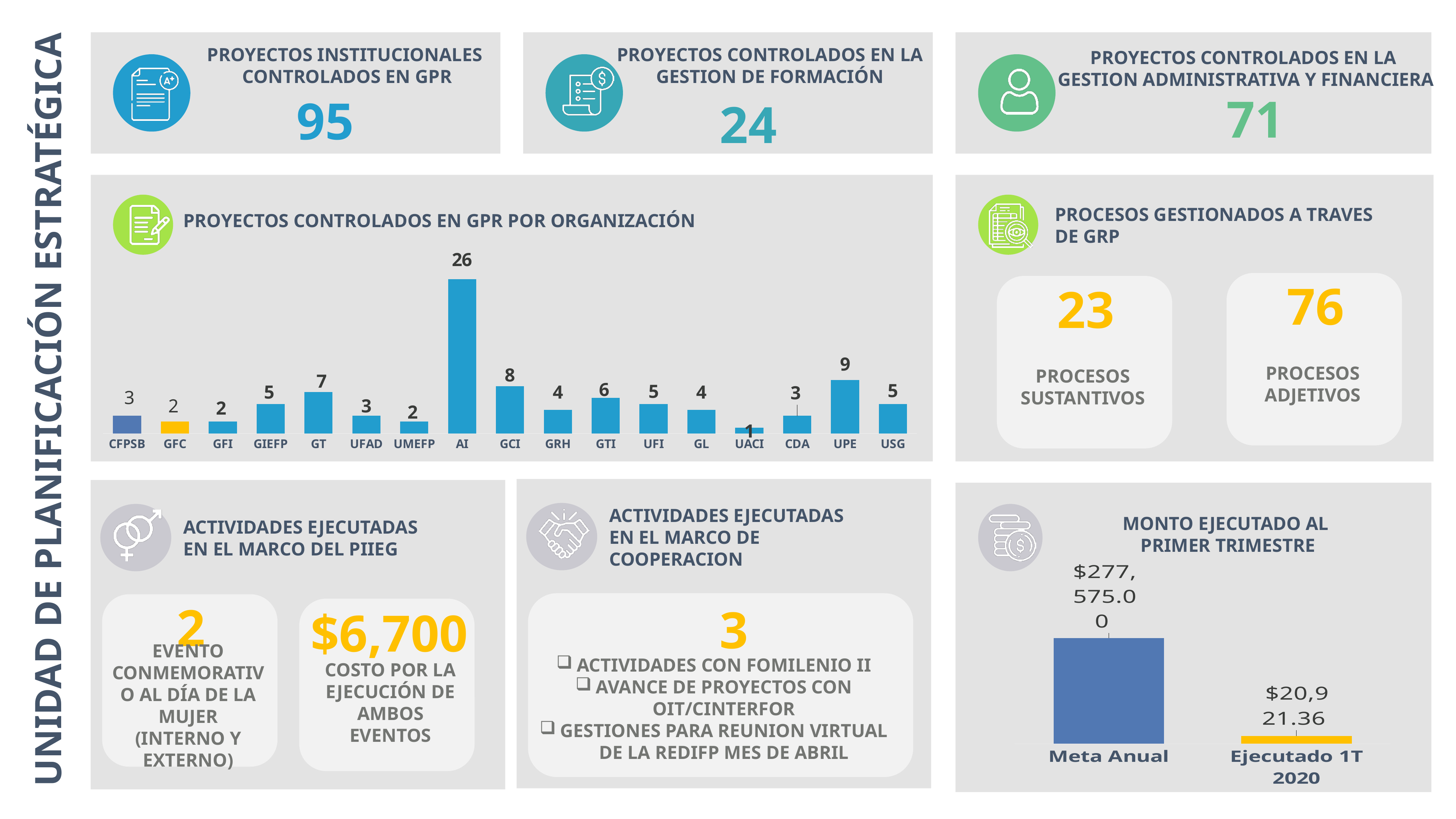
In the 'PROYECTOS CONTROLADOS EN GPR POR ORGANIZACIÓN' chart, what is the value for UPE? 9 In the 'PROYECTOS CONTROLADOS EN GPR POR ORGANIZACIÓN' chart, what is the difference between the values for AI and GCI? 18 In the 'MONTO EJECUTADO AL PRIMER TRIMESTRE' chart, which bar is larger, Meta Anual or Ejecutado 1T 2020? Meta Anual In the 'PROYECTOS CONTROLADOS EN GPR POR ORGANIZACIÓN' chart, which is larger, GT or GTI? GT In the 'PROYECTOS CONTROLADOS EN GPR POR ORGANIZACIÓN' chart, which organization has the highest value? AI In the 'MONTO EJECUTADO AL PRIMER TRIMESTRE' chart, what is the value for Meta Anual? $277,575.00 In the 'MONTO EJECUTADO AL PRIMER TRIMESTRE' chart, what is the value for Ejecutado 1T 2020? $20,921.36 How many bars are shown in the 'MONTO EJECUTADO AL PRIMER TRIMESTRE' chart? 2 How many organizations are shown in the 'PROYECTOS CONTROLADOS EN GPR POR ORGANIZACIÓN' chart? 17 In the 'PROYECTOS CONTROLADOS EN GPR POR ORGANIZACIÓN' chart, what is the value for AI? 26 What kind of chart is 'PROYECTOS CONTROLADOS EN GPR POR ORGANIZACIÓN'? Bar chart In the 'PROYECTOS CONTROLADOS EN GPR POR ORGANIZACIÓN' chart, which organization has the lowest value? UACI